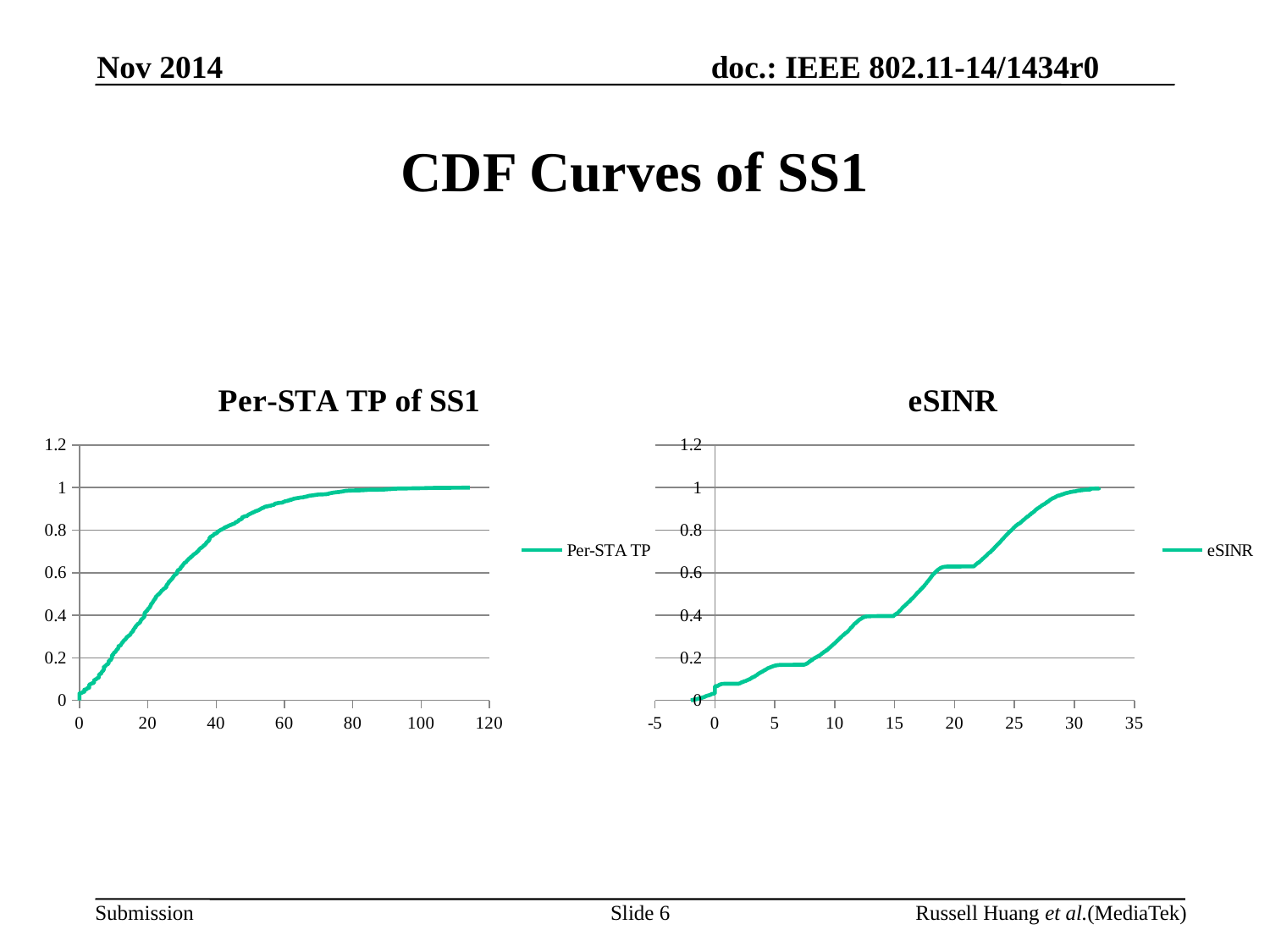
What is the legend entry of the "Per-STA TP of SS1" chart? Per-STA TP What kind of chart is the "Per-STA TP of SS1" chart? line chart In the "eSINR" chart, is the value at x = 10 greater or less than 0.4? less In the "eSINR" chart, is the value at x = 25 greater or less than 0.6? greater In the "eSINR" chart, do the values rise or fall along the x axis? rise In the "Per-STA TP of SS1" chart, do the values rise or fall along the x axis? rise What kind of chart is the "eSINR" chart? line chart In the "Per-STA TP of SS1" chart, is the value at x = 40 greater or less than 0.6? greater How many series does the legend of the "eSINR" chart list? 1 What is the title of the chart on the right side of the slide? eSINR How many series does the legend of the "Per-STA TP of SS1" chart list? 1